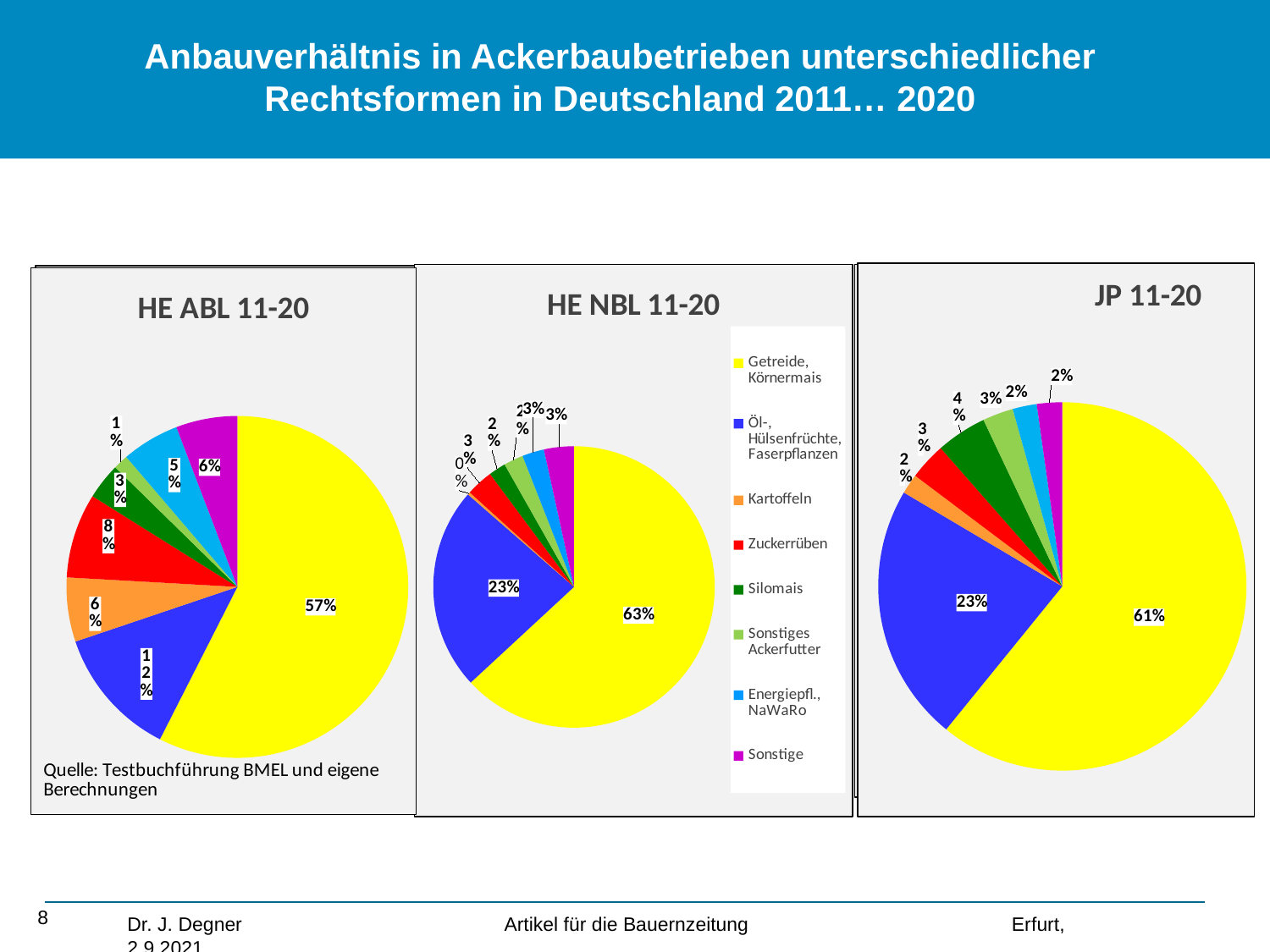
How many categories does the legend list? 8 In the HE ABL 11-20 chart, what is the difference between the Getreide, Körnermais share and the Öl-, Hülsenfrüchte, Faserpflanzen share? 45 percentage points In the HE NBL 11-20 chart, what share does Getreide, Körnermais have? 63% In the HE ABL 11-20 chart, what share does Öl-, Hülsenfrüchte, Faserpflanzen have? 12% In the JP 11-20 chart, what share does Öl-, Hülsenfrüchte, Faserpflanzen have? 23% Which chart has the larger Getreide, Körnermais share, HE NBL 11-20 or JP 11-20? HE NBL 11-20 What kind of charts are shown on the slide? Pie charts In the HE ABL 11-20 chart, which category has the largest slice? Getreide, Körnermais In the HE ABL 11-20 chart, which category has the smallest slice? Sonstiges Ackerfutter